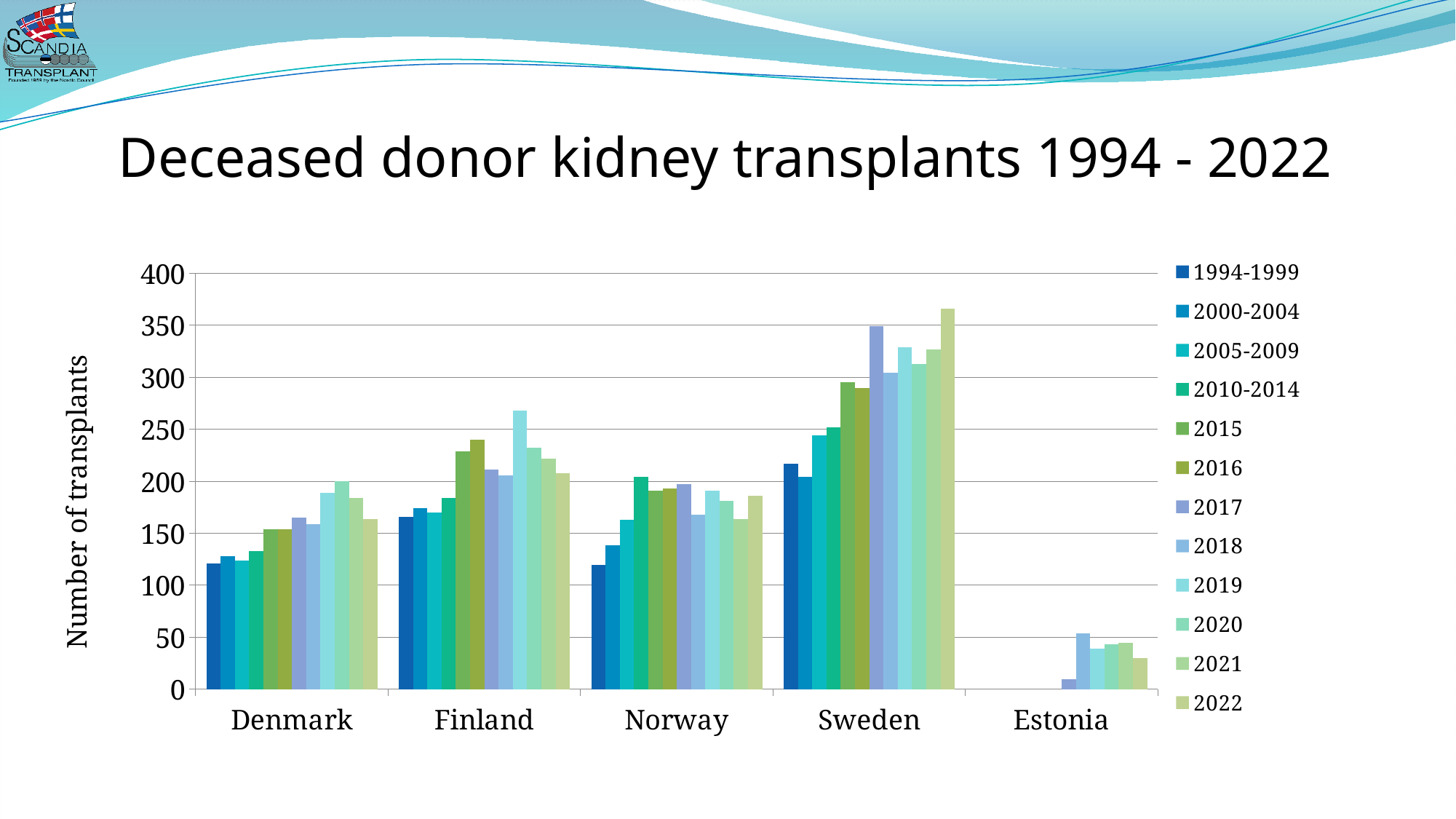
Which country has the lowest number of deceased donor kidney transplants in 2022? Estonia What kind of chart is shown on the slide? Bar chart How many countries are shown on the x axis of the chart? 5 Is the value for Estonia in 2017 greater or less than 50? less Is the value for Denmark in 1994-1999 greater or less than 150? less For Finland, which period has the highest bar? 2019 For Sweden, which is larger: the value for 2017 or the value for 2018? 2017 Is the value for Finland in 2019 greater or less than 250? greater How many series (time periods) does the legend list? 12 For Sweden, which period has the highest bar? 2022 Which country has the highest number of deceased donor kidney transplants in 2022? Sweden